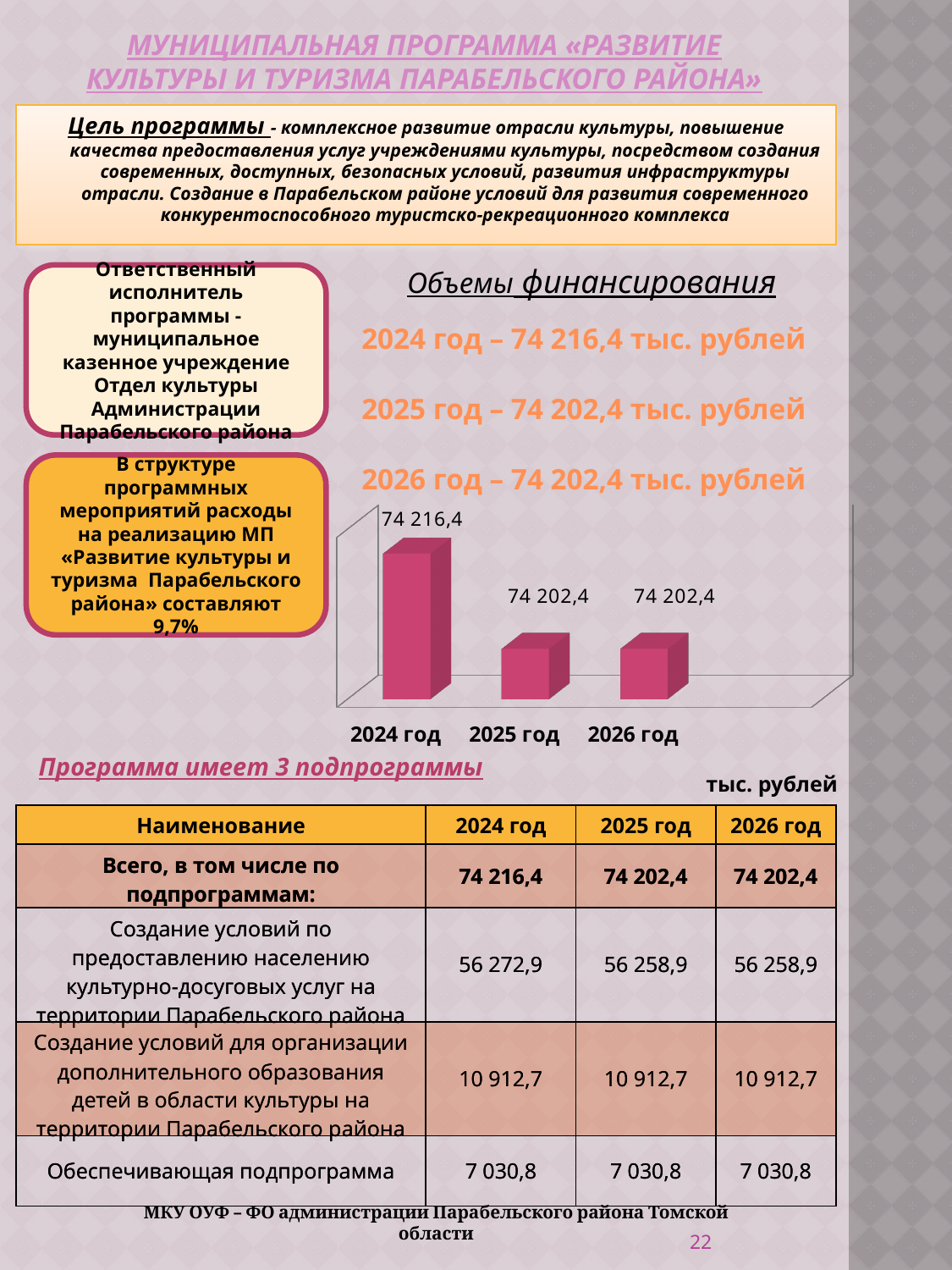
Does the value rise or fall from 2024 год to 2025 год in the bar chart? Fall What is the difference between the values for 2024 год and 2025 год in the bar chart? 14,0 What is the value shown for 2024 год in the bar chart? 74 216,4 What is the value shown for 2026 год in the bar chart? 74 202,4 Which year has the highest bar in the chart? 2024 год What is the value shown for 2025 год in the bar chart? 74 202,4 Which is larger in the bar chart, the value for 2024 год or the value for 2026 год? 2024 год What colour are the bars in the chart? Pink (magenta) How many bars (years) are shown in the chart? 3 What heading appears above the bar chart? Объемы финансирования What kind of chart is shown on the slide? Bar chart